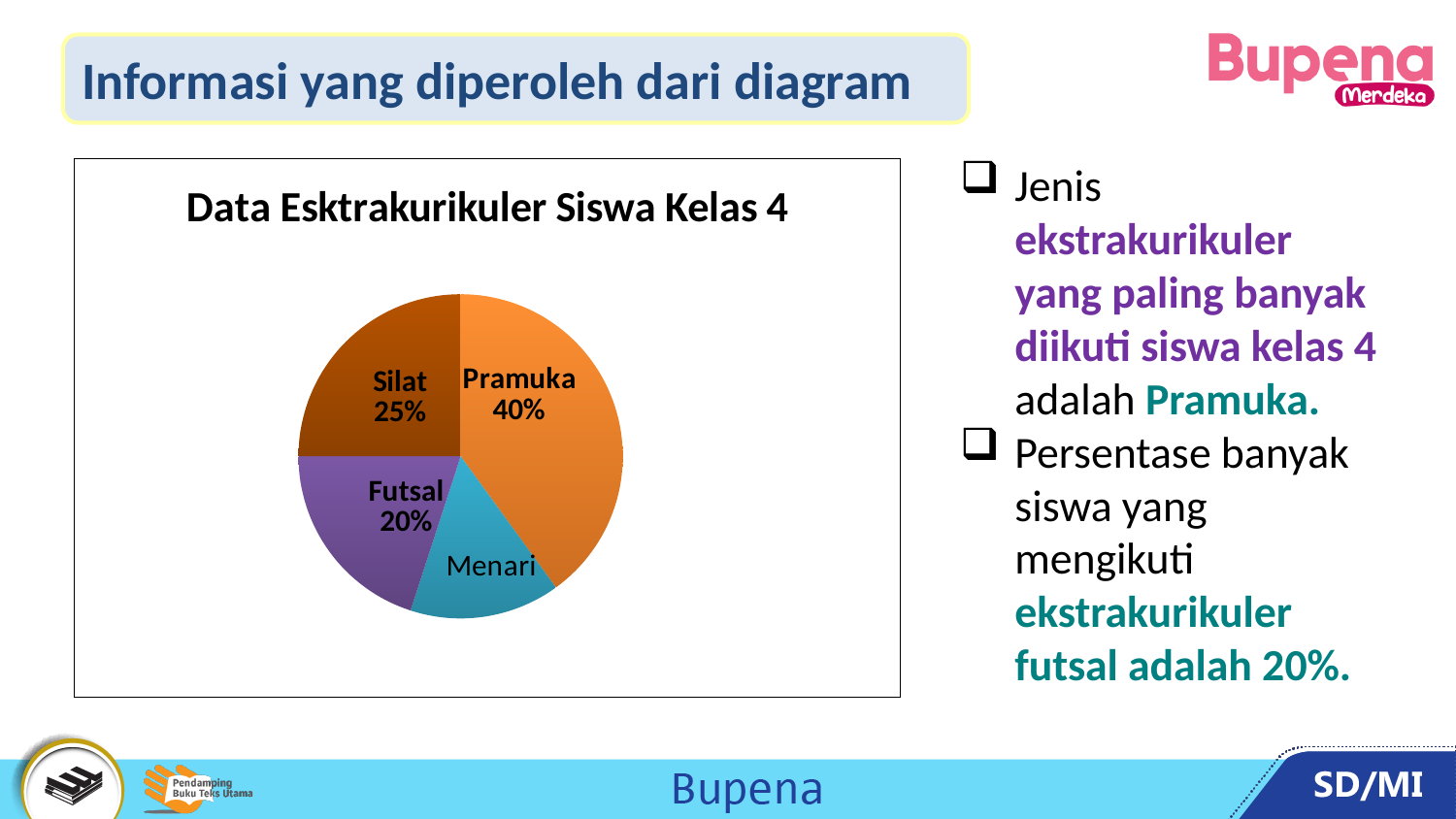
What type of chart is shown on the slide? pie chart How many categories are shown in the pie chart? 4 What percentage of students take Futsal? 20% Which extracurricular activity has the largest share of the pie? Pramuka Which extracurricular activity has the smallest share of the pie? Menari What percentage of students take Pramuka? 40% Which is larger, the share for Silat or the share for Menari? Silat What is the difference between the Silat and Futsal percentages? 5% What is the title of the chart? Data Esktrakurikuler Siswa Kelas 4 What percentage of students take Silat? 25% Which is larger, the share for Futsal or the share for Pramuka? Pramuka What is the difference between the Pramuka and Silat percentages? 15%